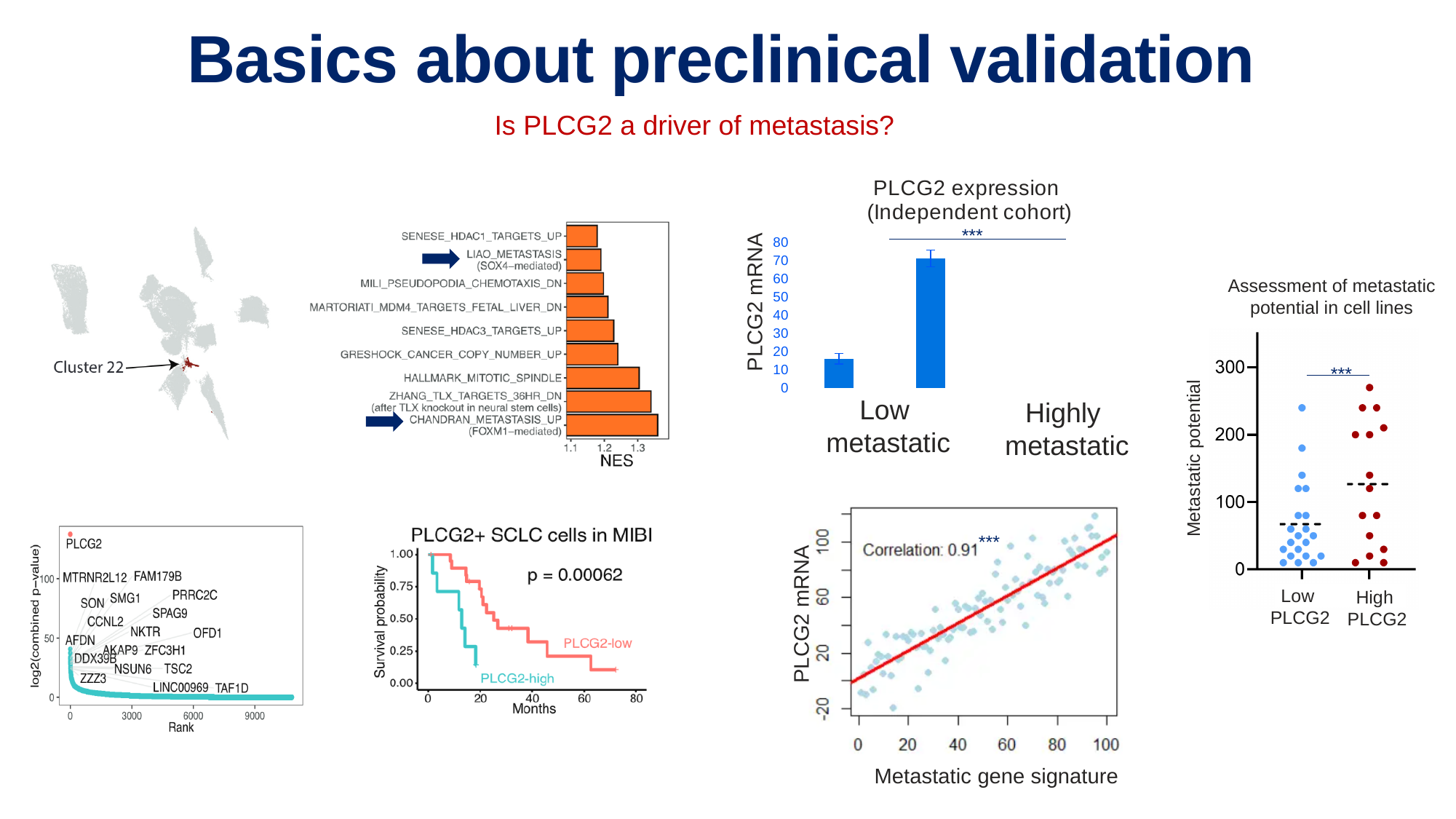
What kind of chart is the 'PLCG2 expression (Independent cohort)' chart? bar chart What correlation value is printed on the scatter plot of PLCG2 mRNA versus Metastatic gene signature? 0.91 In the 'PLCG2 expression (Independent cohort)' chart, is the value for Highly metastatic greater or less than 60? greater In the NES chart with orange bars, which gene set has the lowest NES? SENESE_HDAC1_TARGETS_UP In the NES chart with orange bars, which gene set has the highest NES? CHANDRAN_METASTASIS_UP How many categories are shown on the x axis of the 'PLCG2 expression (Independent cohort)' chart? 2 What is the p-value shown on the 'PLCG2+ SCLC cells in MIBI' survival chart? p = 0.00062 In the 'PLCG2 expression (Independent cohort)' chart, which group has the higher PLCG2 mRNA value, Low metastatic or Highly metastatic? Highly metastatic How many survival curves are shown in the 'PLCG2+ SCLC cells in MIBI' chart? 2 What is the x-axis label of the scatter plot in the lower right of the slide? Metastatic gene signature In the 'PLCG2 expression (Independent cohort)' chart, is the value for Low metastatic greater or less than 20? less How many gene sets are plotted in the NES chart with orange bars? 9